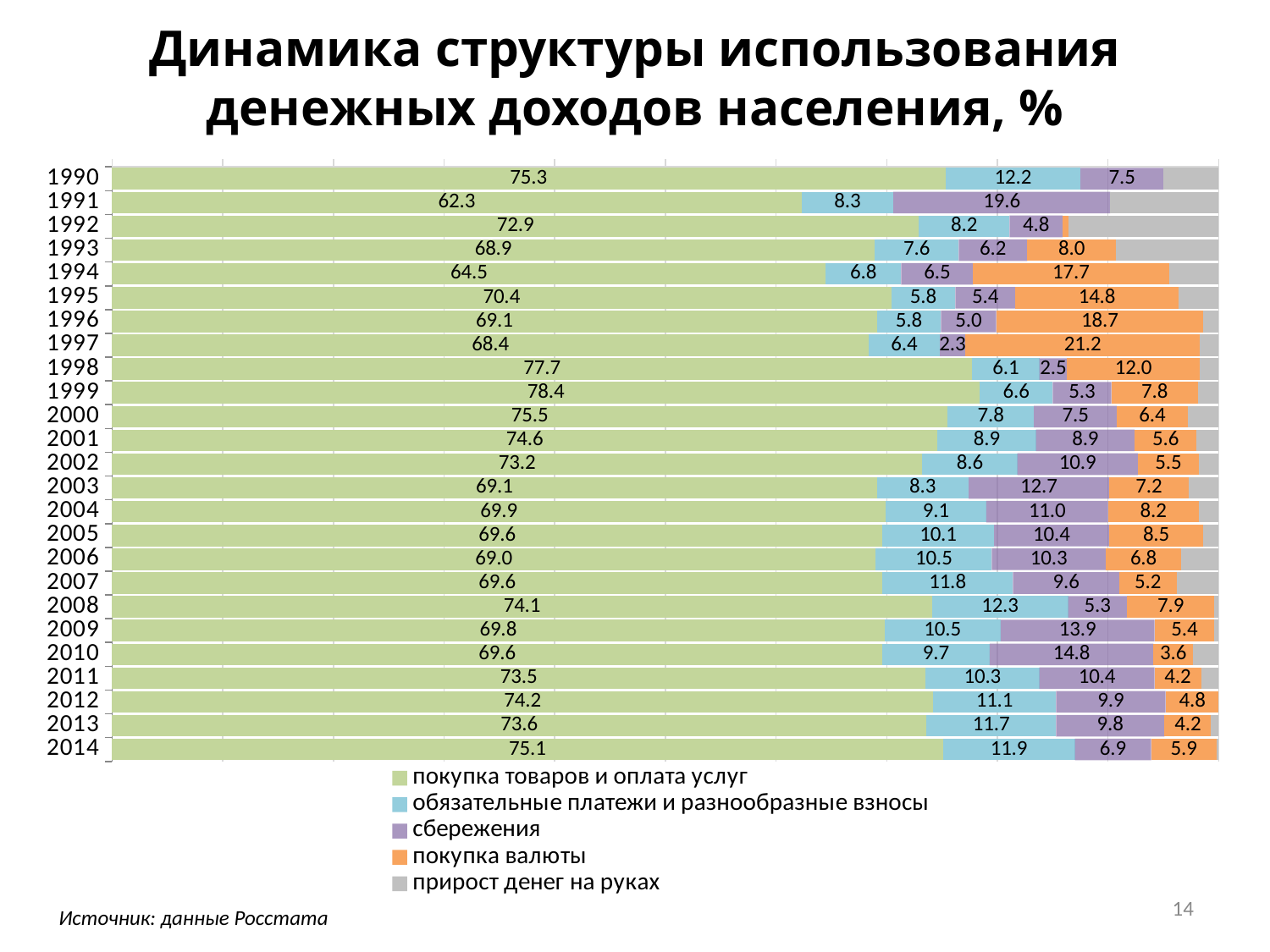
Which year has the larger value for «покупка валюты», 1994 or 1996? 1996 In which year is the value for «сбережения» the highest? 1991 What is the difference between the «покупка товаров и оплата услуг» values for 1999 and 1991? 16.1 In which year is the value for «покупка товаров и оплата услуг» the highest? 1999 What kind of chart is shown on the slide? Stacked bar chart What is the value for «обязательные платежи и разнообразные взносы» in 2014? 11.9 In which year is the value for «покупка товаров и оплата услуг» the lowest? 1991 What is the value for «сбережения» in 2009? 13.9 How many years are shown on the chart? 25 How many series does the legend list? 5 What is the value for «покупка валюты» in 1997? 21.2 What is the value for «покупка товаров и оплата услуг» in 1990? 75.3